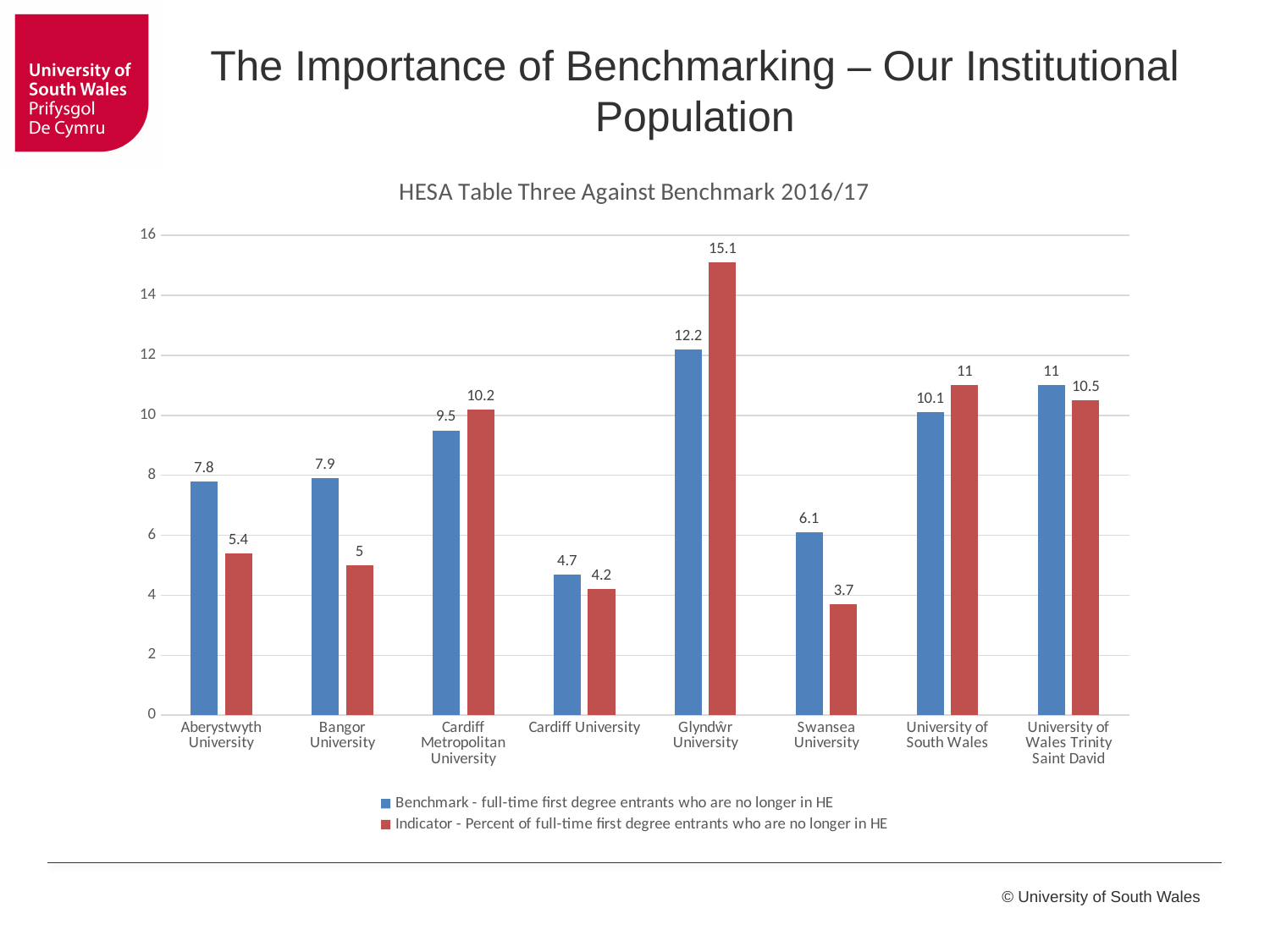
What is the Benchmark value for Glyndŵr University? 12.2 How many series does the legend list? 2 What is the difference between the Benchmark and Indicator values for Aberystwyth University? 2.4 What is the Indicator value for Cardiff Metropolitan University? 10.2 What is the difference between the Indicator and Benchmark values for Glyndŵr University? 2.9 Which is larger for University of South Wales, the Benchmark or the Indicator? Indicator What is the Indicator value for Swansea University? 3.7 What kind of chart is shown? Bar chart How many universities are shown on the x axis? 8 Which university has the lowest Benchmark value? Cardiff University Which university has the highest Indicator value? Glyndŵr University What is the title of the chart? HESA Table Three Against Benchmark 2016/17